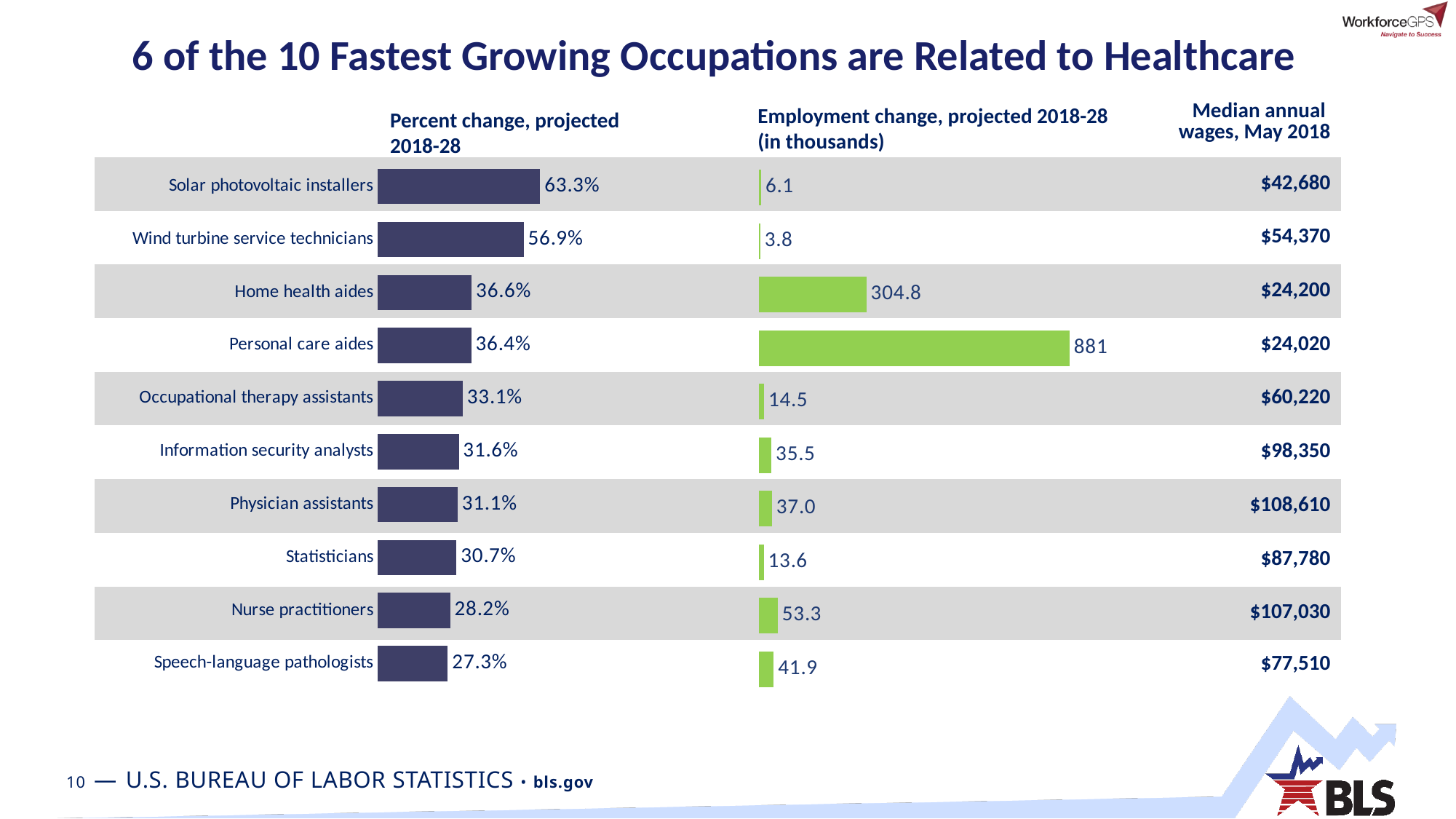
What colour are the bars in the 'Employment change, projected 2018-28 (in thousands)' chart? Green In the 'Percent change, projected 2018-28' chart, which occupation has the lowest value? Speech-language pathologists In the 'Percent change, projected 2018-28' chart, what is the difference between Solar photovoltaic installers and Wind turbine service technicians? 6.4% In the 'Employment change, projected 2018-28 (in thousands)' chart, what is the value for Nurse practitioners? 53.3 In the 'Employment change, projected 2018-28 (in thousands)' chart, which occupation has the highest value? Personal care aides In the 'Employment change, projected 2018-28 (in thousands)' chart, which is larger: Physician assistants or Information security analysts? Physician assistants In the 'Employment change, projected 2018-28 (in thousands)' chart, what is the difference between Personal care aides and Home health aides? 576.2 In the 'Percent change, projected 2018-28' chart, which occupation has the highest value? Solar photovoltaic installers In the 'Percent change, projected 2018-28' chart, what is the value for Home health aides? 36.6% How many occupations are shown in the 'Percent change, projected 2018-28' chart? 10 In the 'Employment change, projected 2018-28 (in thousands)' chart, which occupation has the lowest value? Wind turbine service technicians What kind of chart is the 'Employment change, projected 2018-28 (in thousands)' chart? Bar chart